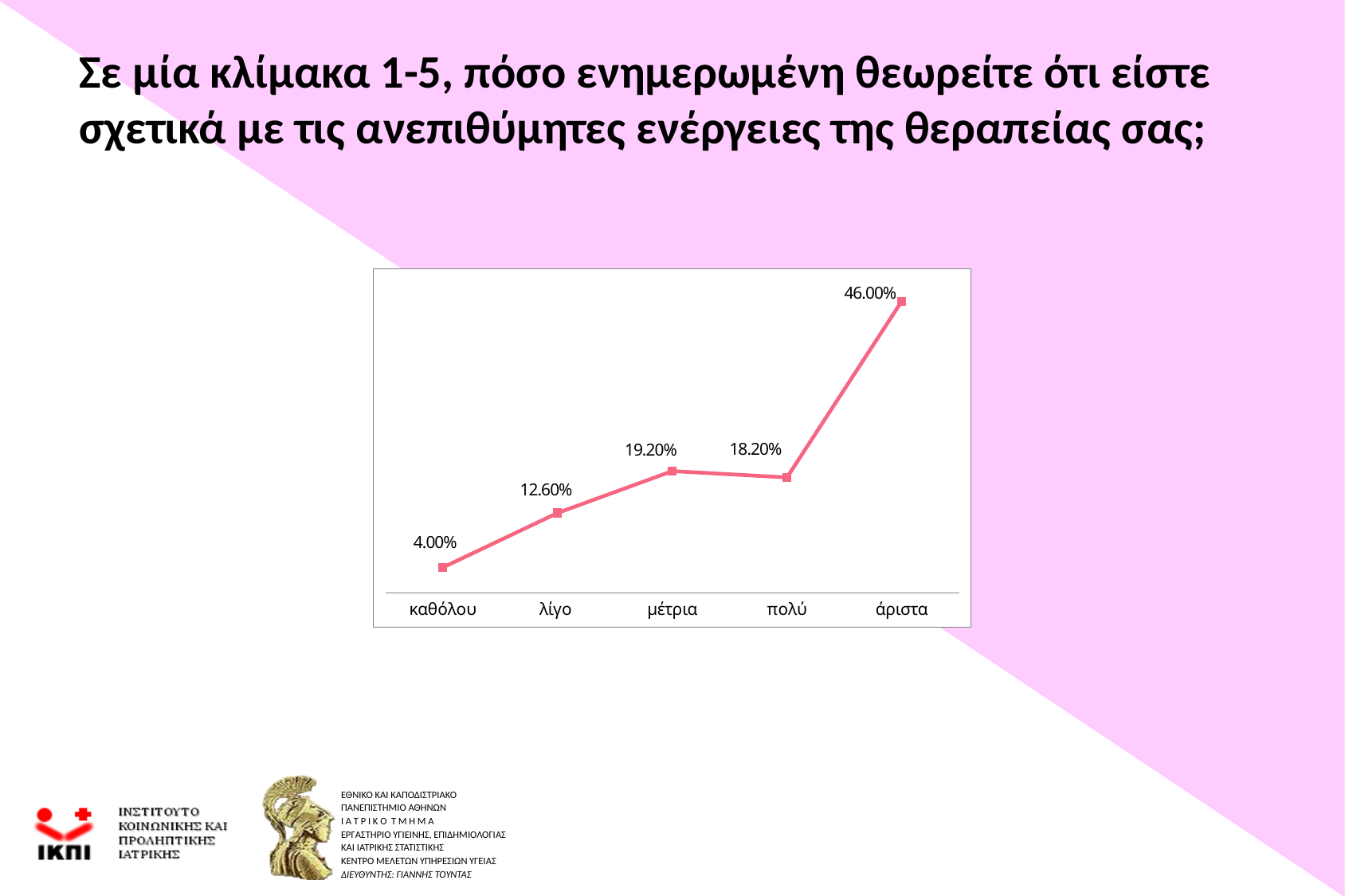
What is the value for λίγο? 12.60% What is the value for μέτρια? 19.20% What is the difference between the values for άριστα and καθόλου? 42.00% What is the value for άριστα? 46.00% What is the value for καθόλου? 4.00% What is the value for πολύ? 18.20% Which category has the lowest value? καθόλου Which category has the highest value? άριστα What is the difference between the values for μέτρια and πολύ? 1.00% Which is larger, the value for λίγο or the value for πολύ? πολύ What kind of chart is shown on the slide? line chart How many categories are shown on the x axis? 5